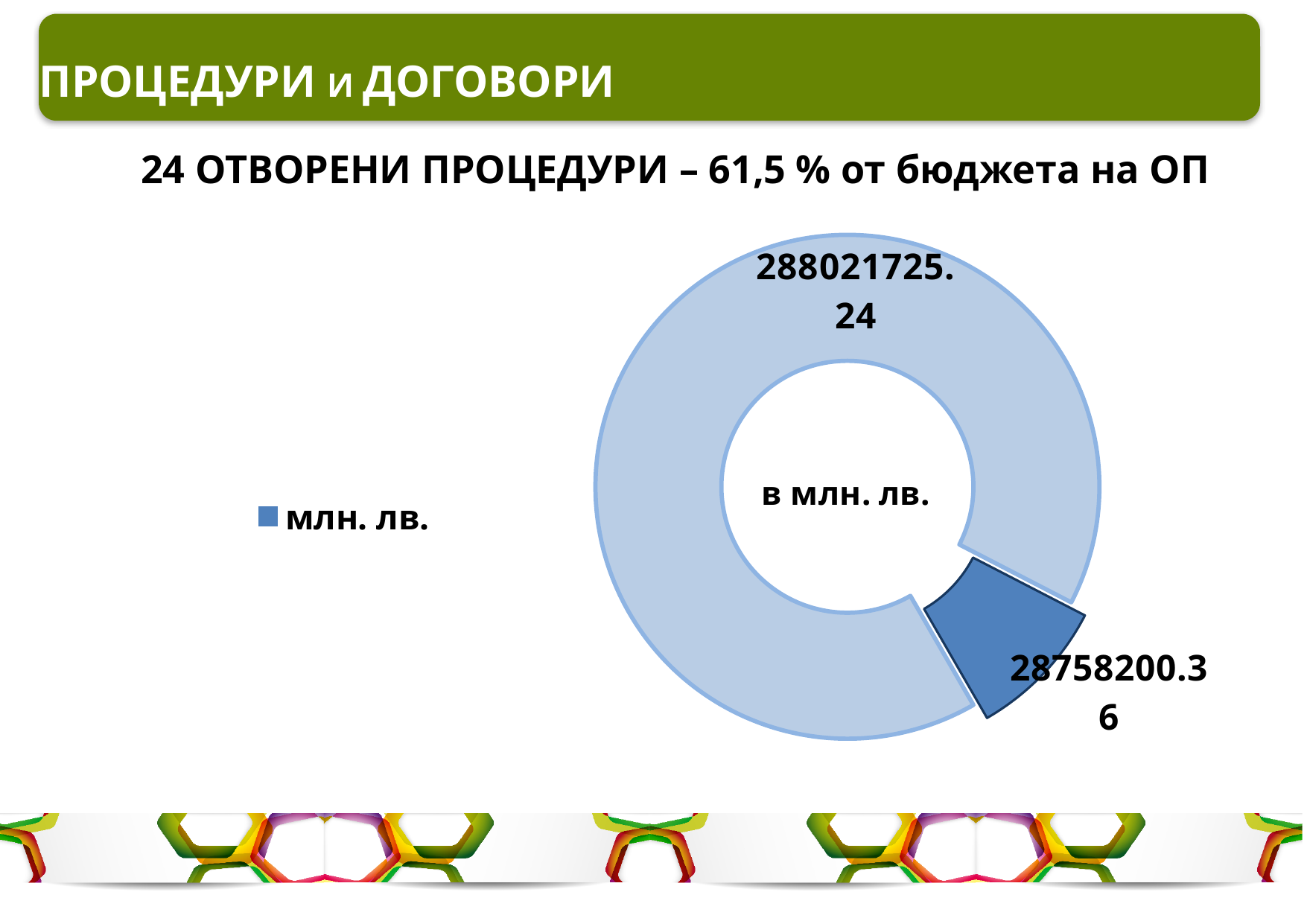
How many slices does the doughnut chart have? 2 What is the total of the two values shown on the doughnut chart? 316779925.60 Which is larger: the light-blue slice or the dark-blue slice? The light-blue slice What text is written in the centre of the doughnut chart? в млн. лв. What is the value labelled on the large light-blue slice of the doughnut chart? 288021725.24 What entry does the chart legend show? млн. лв. How many series does the chart legend list? 1 What is the difference between the two values shown on the doughnut chart? 259263524.88 What is the value labelled on the small dark-blue slice of the doughnut chart? 28758200.36 What kind of chart is shown on the slide? Doughnut chart Which slice of the doughnut chart has the highest value? The light-blue slice (288021725.24) Which slice of the doughnut chart has the lowest value? The dark-blue slice (28758200.36)